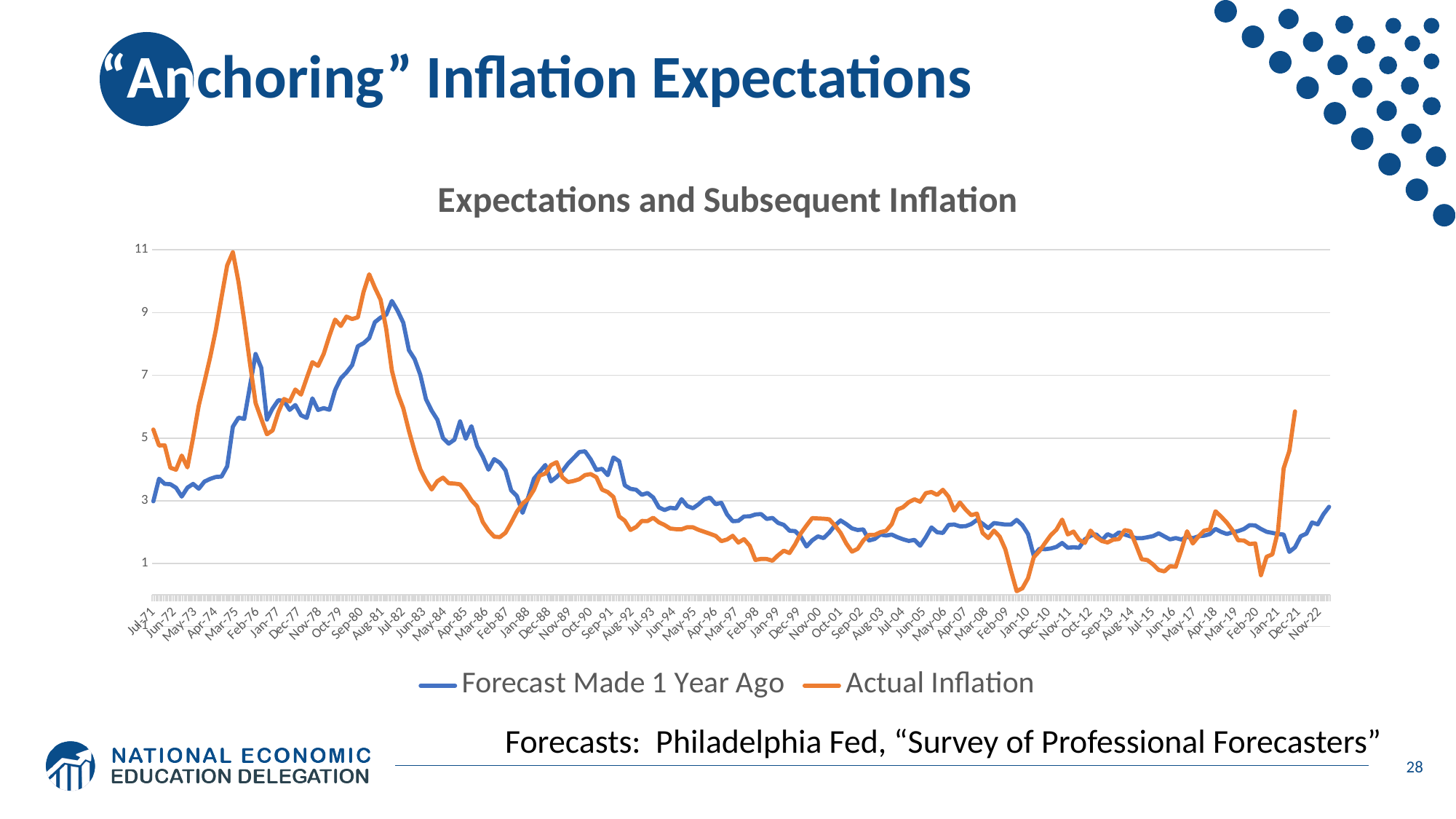
Does the Forecast Made 1 Year Ago series rise or fall between Jul-82 and Jan-99? fall What kind of chart is shown on the slide? line chart How many series does the legend list? 2 Does the Actual Inflation series rise or fall between Feb-20 and Dec-21? rise Is the peak value of Forecast Made 1 Year Ago around Jul-82 greater or less than 7? greater Is the value of Actual Inflation around Jan-10 greater or less than 1? less Is the value of Forecast Made 1 Year Ago at Nov-22 greater or less than 5? less Which series is drawn in orange? Actual Inflation Which series reaches the higher peak value, Forecast Made 1 Year Ago or Actual Inflation? Actual Inflation What is the title of the chart? Expectations and Subsequent Inflation